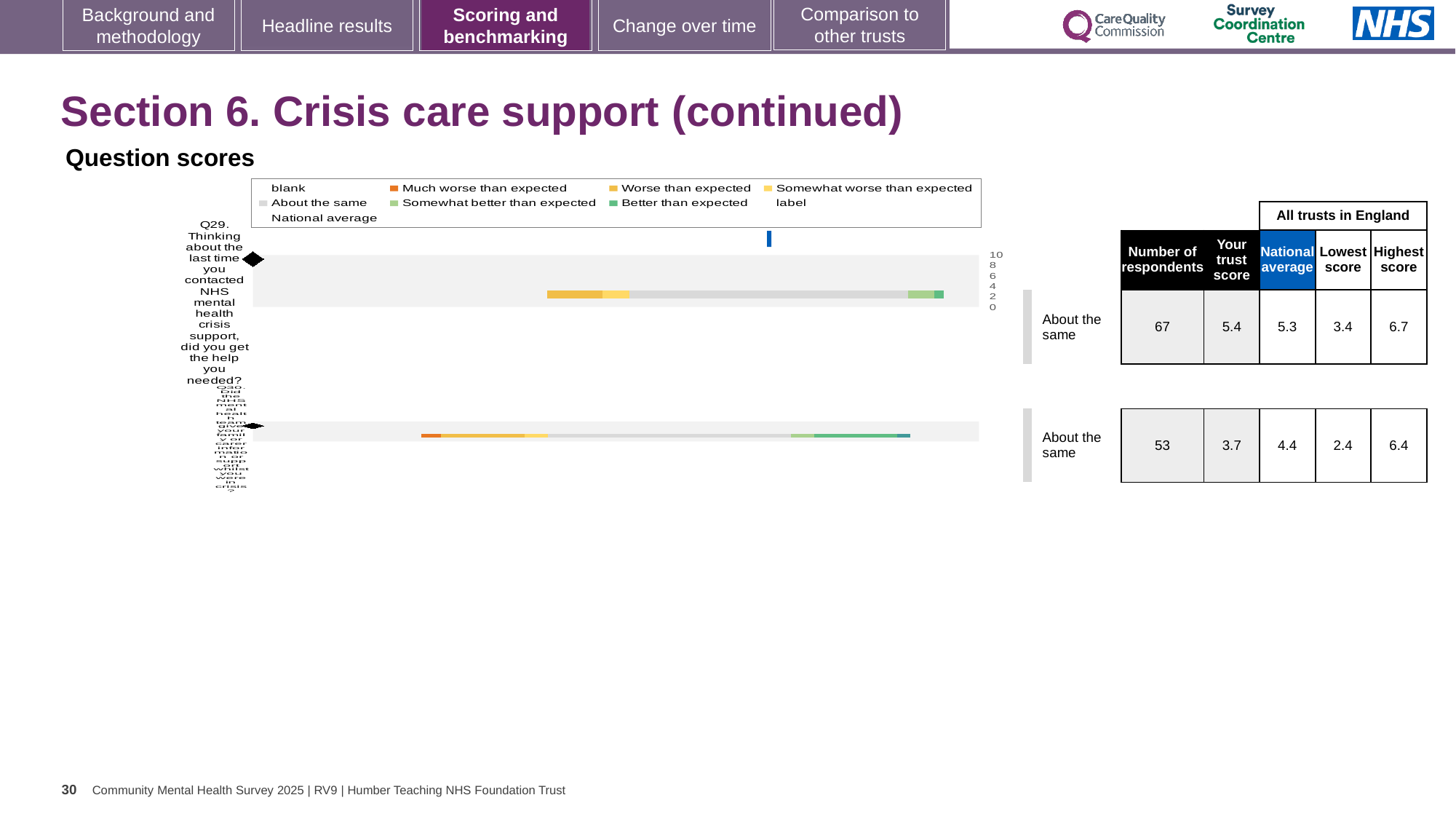
For Q30, what is the difference between the national average and the trust's score? 0.7 For Q29, what is the difference between the highest score and the lowest score among all trusts in England? 3.3 In the Q29 chart's table, what is the number of respondents? 67 In the Q30 chart's table, what is the lowest score among all trusts in England? 2.4 In the Q30 chart's table, what is the highest score among all trusts in England? 6.4 In the Q29 chart's table, what is the trust's score? 5.4 What kind of chart is used to show the question scores? Bar chart In the Q29 chart's table, what is the national average? 5.3 Which question has more respondents, Q29 or Q30? Q29 How many survey questions are plotted on the slide? 2 What benchmark category is shown next to both the Q29 and Q30 charts? About the same For Q29, which is larger: the trust's score or the national average? The trust's score